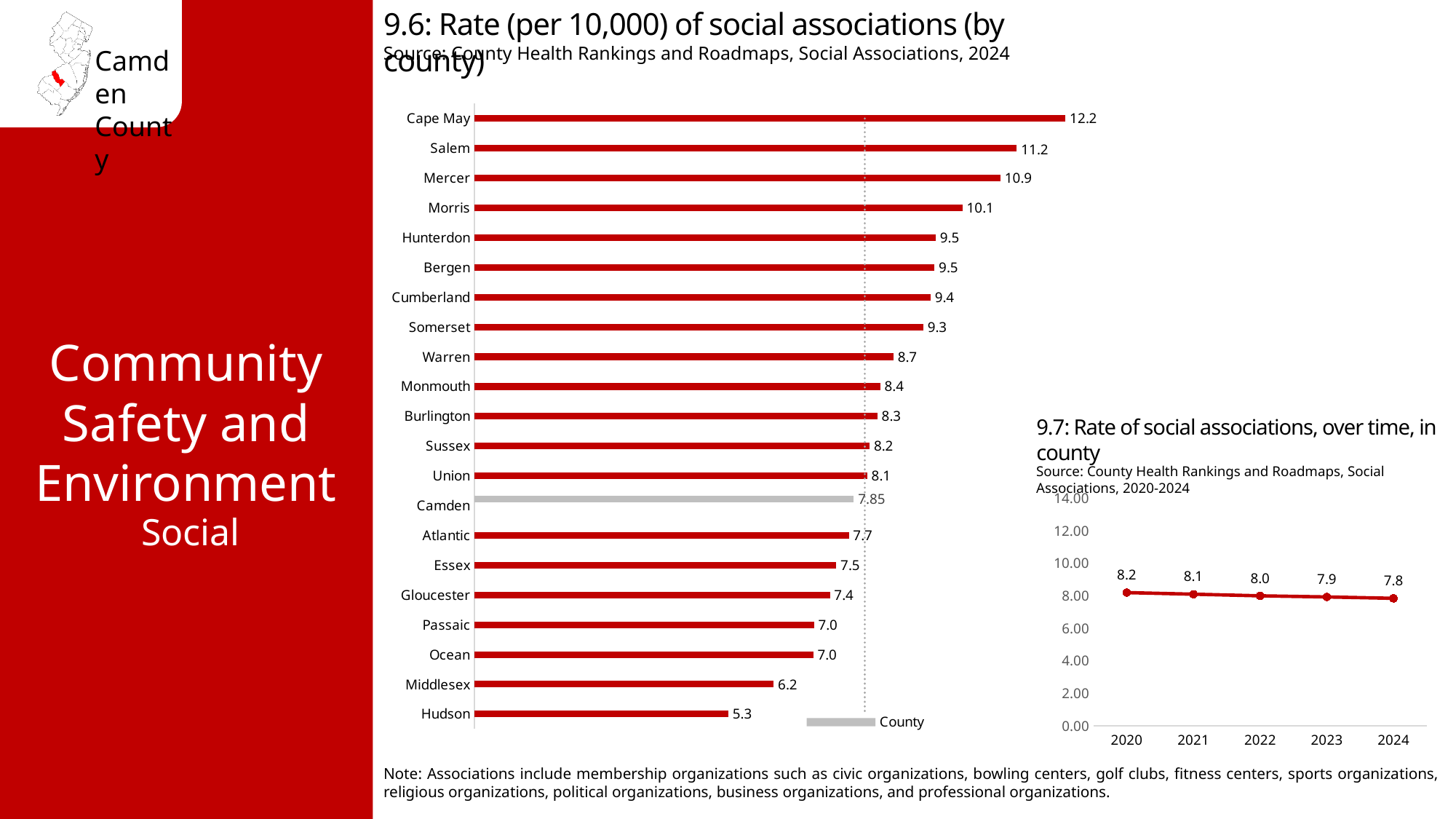
In the chart '9.6: Rate (per 10,000) of social associations (by county)', which has a higher value, Mercer or Morris? Mercer In the chart '9.6: Rate (per 10,000) of social associations (by county)', what is the difference between the values for Salem and Middlesex? 5.0 In the chart '9.7: Rate of social associations, over time, in county', do the values rise or fall from 2020 to 2024? Fall How many counties are shown in the chart '9.6: Rate (per 10,000) of social associations (by county)'? 21 What kind of chart is '9.7: Rate of social associations, over time, in county'? Line chart In the chart '9.6: Rate (per 10,000) of social associations (by county)', which county has the lowest rate? Hudson In the chart '9.6: Rate (per 10,000) of social associations (by county)', what is the value for Camden? 7.85 In the chart '9.7: Rate of social associations, over time, in county', what is the difference between the 2020 and 2024 values? 0.4 What kind of chart is '9.6: Rate (per 10,000) of social associations (by county)'? Bar chart In the chart '9.7: Rate of social associations, over time, in county', what is the value for 2022? 8.0 In the chart '9.6: Rate (per 10,000) of social associations (by county)', what is the value for Cape May? 12.2 In the chart '9.6: Rate (per 10,000) of social associations (by county)', which county has the highest rate? Cape May